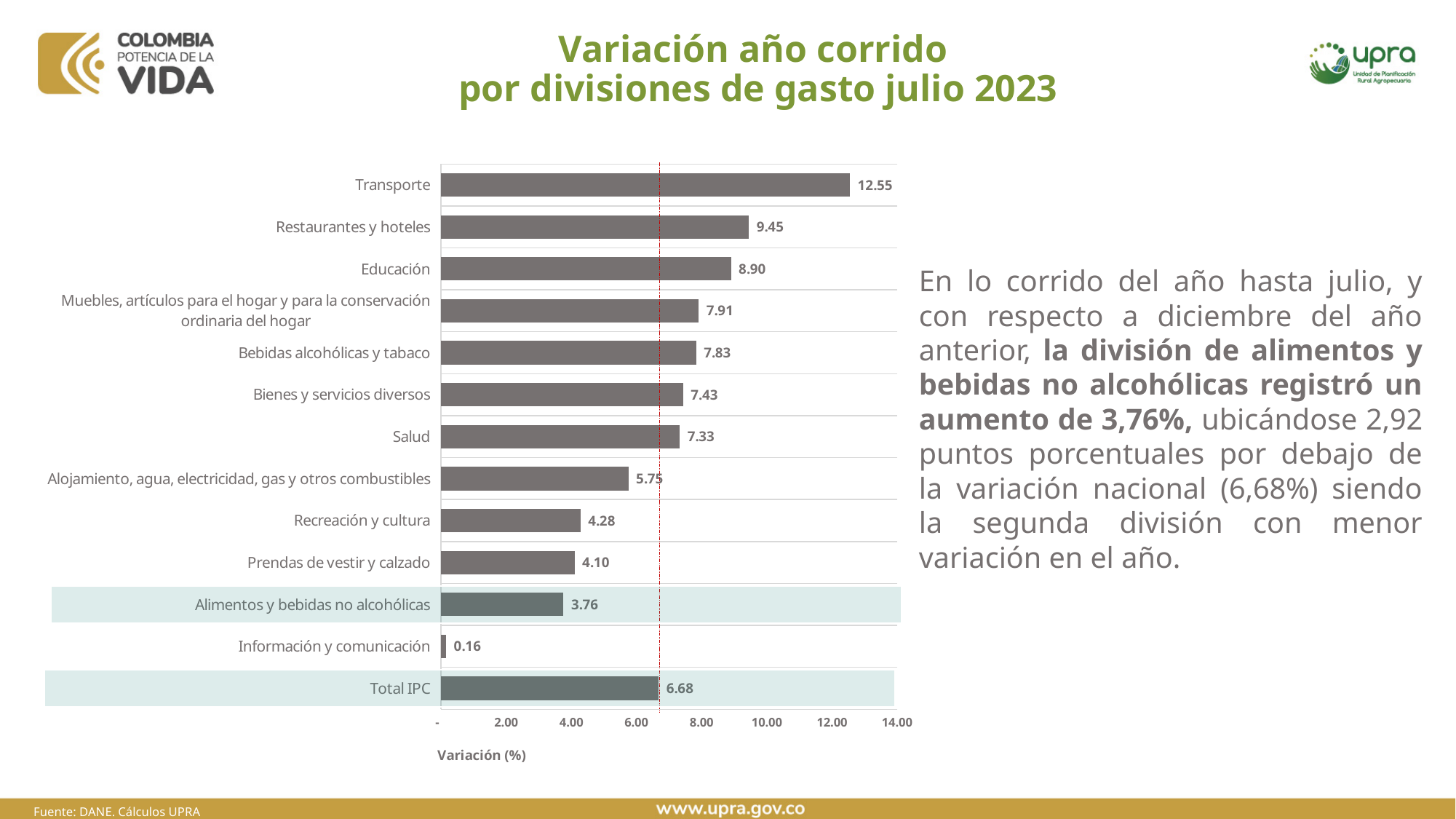
What is the value for Total IPC? 6.68 What kind of chart is shown on the slide? Bar chart What is the difference between the values for Transporte and Restaurantes y hoteles? 3.10 What is the title of the chart? Variación año corrido por divisiones de gasto julio 2023 Which category has the highest value? Transporte Which category has the lowest value? Información y comunicación What is the value for Salud? 7.33 How many categories are shown in the chart? 13 What is the label of the horizontal axis? Variación (%) What is the value for Transporte? 12.55 What is the value for Alimentos y bebidas no alcohólicas? 3.76 Which is larger, the value for Educación or the value for Salud? Educación